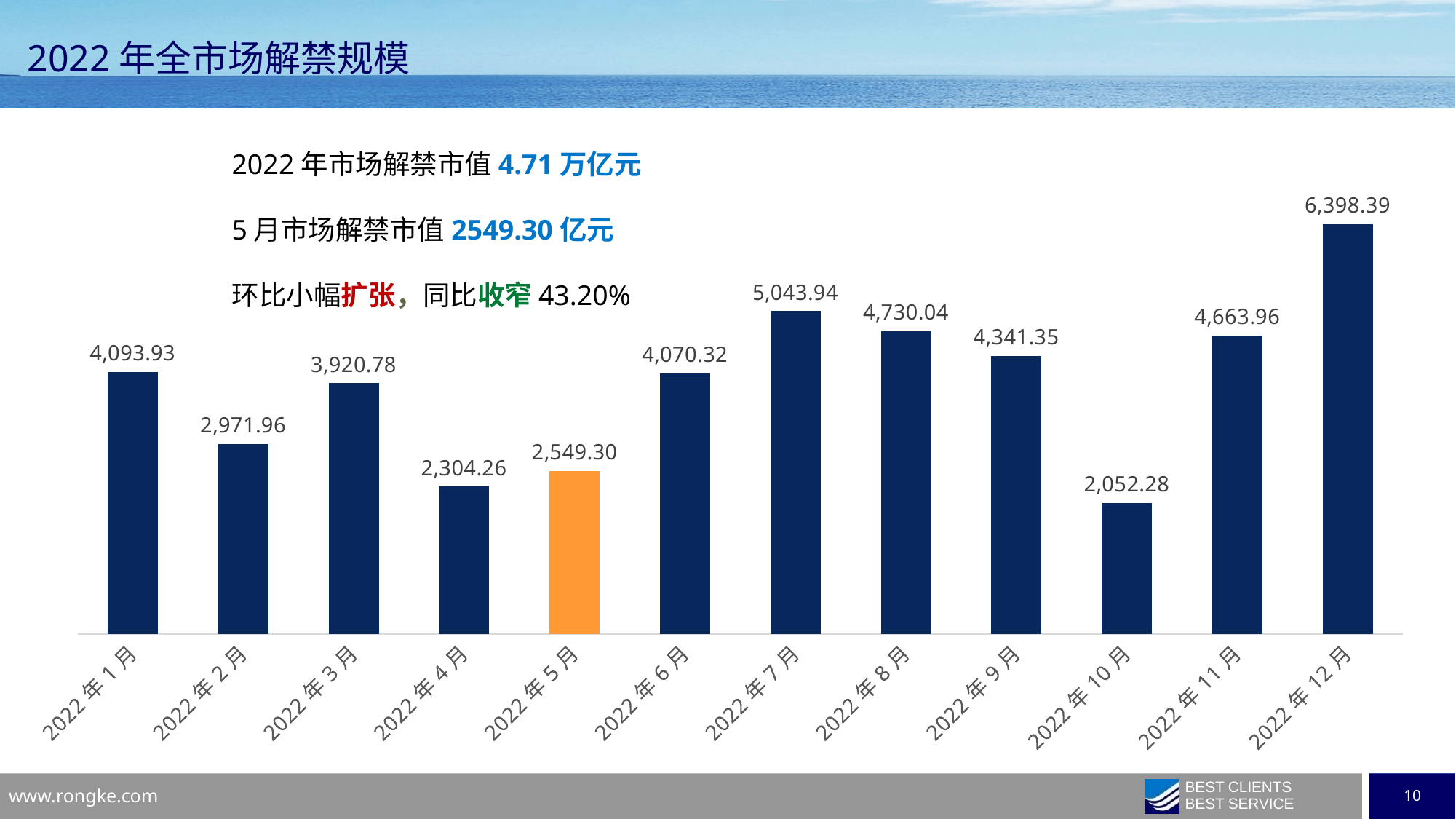
What kind of chart is shown on the slide? Bar chart What is the difference between the values for 2022年5月 and 2022年4月? 245.04 How many months are shown on the x axis? 12 What is the value for 2022年5月? 2,549.30 Which is larger, the value for 2022年3月 or 2022年9月? 2022年9月 Do the values rise or fall from 2022年4月 to 2022年7月? Rise What is the value for 2022年10月? 2,052.28 Which month has the lowest value? 2022年10月 What is the value for 2022年7月? 5,043.94 Which month has the highest value? 2022年12月 What is the difference between the values for 2022年12月 and 2022年7月? 1,354.45 Which month's bar is coloured orange? 2022年5月